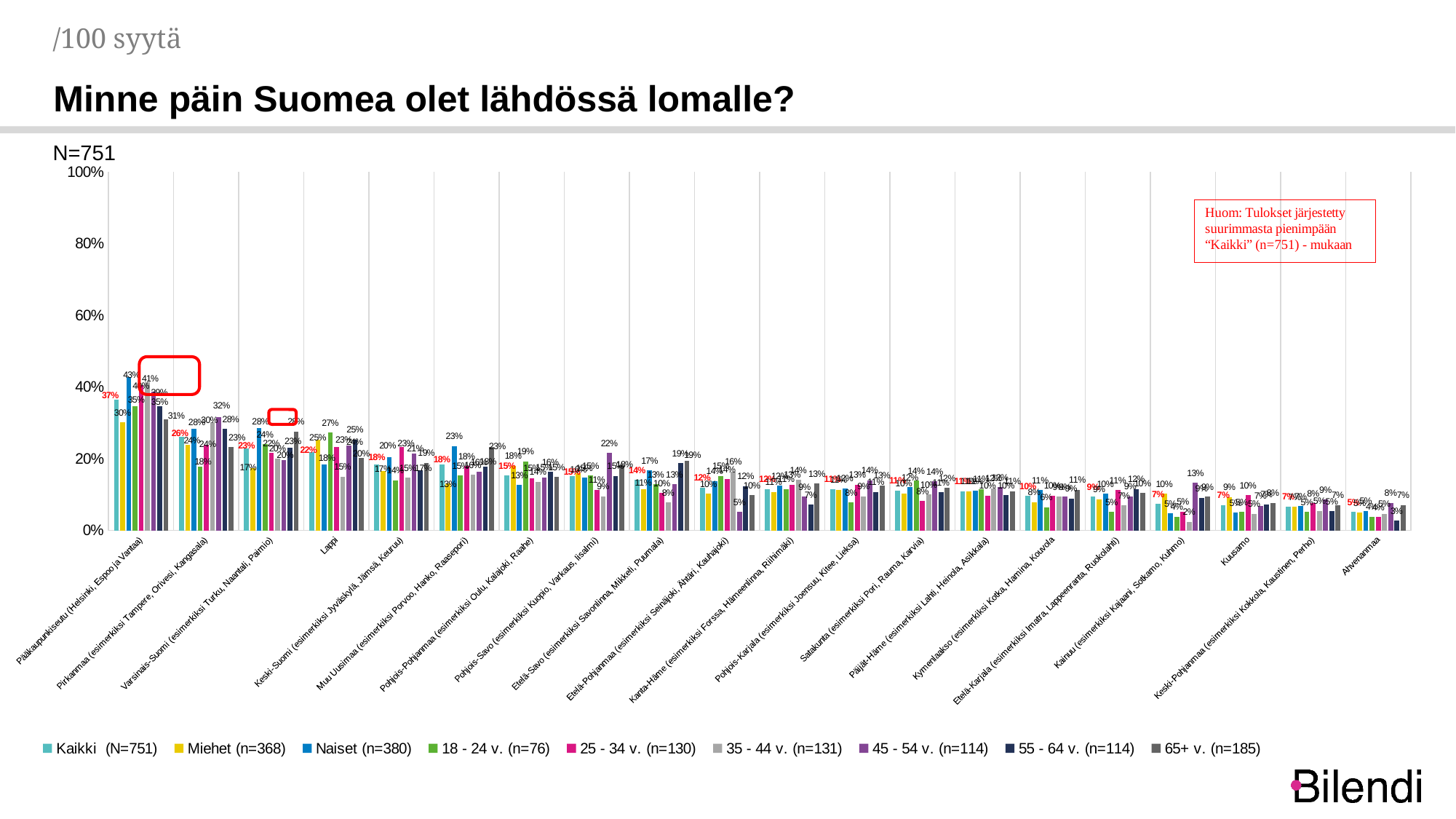
What is the difference between the Naiset (n=380) and Miehet (n=368) values for Pääkaupunkiseutu? 13 percentage points How many regions (categories) are shown on the x axis? 20 What sample size (N) is stated above the chart? N=751 Do the Kaikki (N=751) values rise or fall from left to right along the x axis? fall What is the Kaikki (N=751) value for Pääkaupunkiseutu? 37% Which region has the lowest Kaikki (N=751) value? Ahvenanmaa What is the 18 - 24 v. (n=76) value for Lappi? 27% Which is larger for Kaikki (N=751): Pirkanmaa or Lappi? Pirkanmaa What is the Naiset (n=380) value for Pääkaupunkiseutu? 43% How many series does the legend list? 9 Which region has the highest Kaikki (N=751) value? Pääkaupunkiseutu (Helsinki, Espoo ja Vantaa) What kind of chart is shown on the slide? bar chart